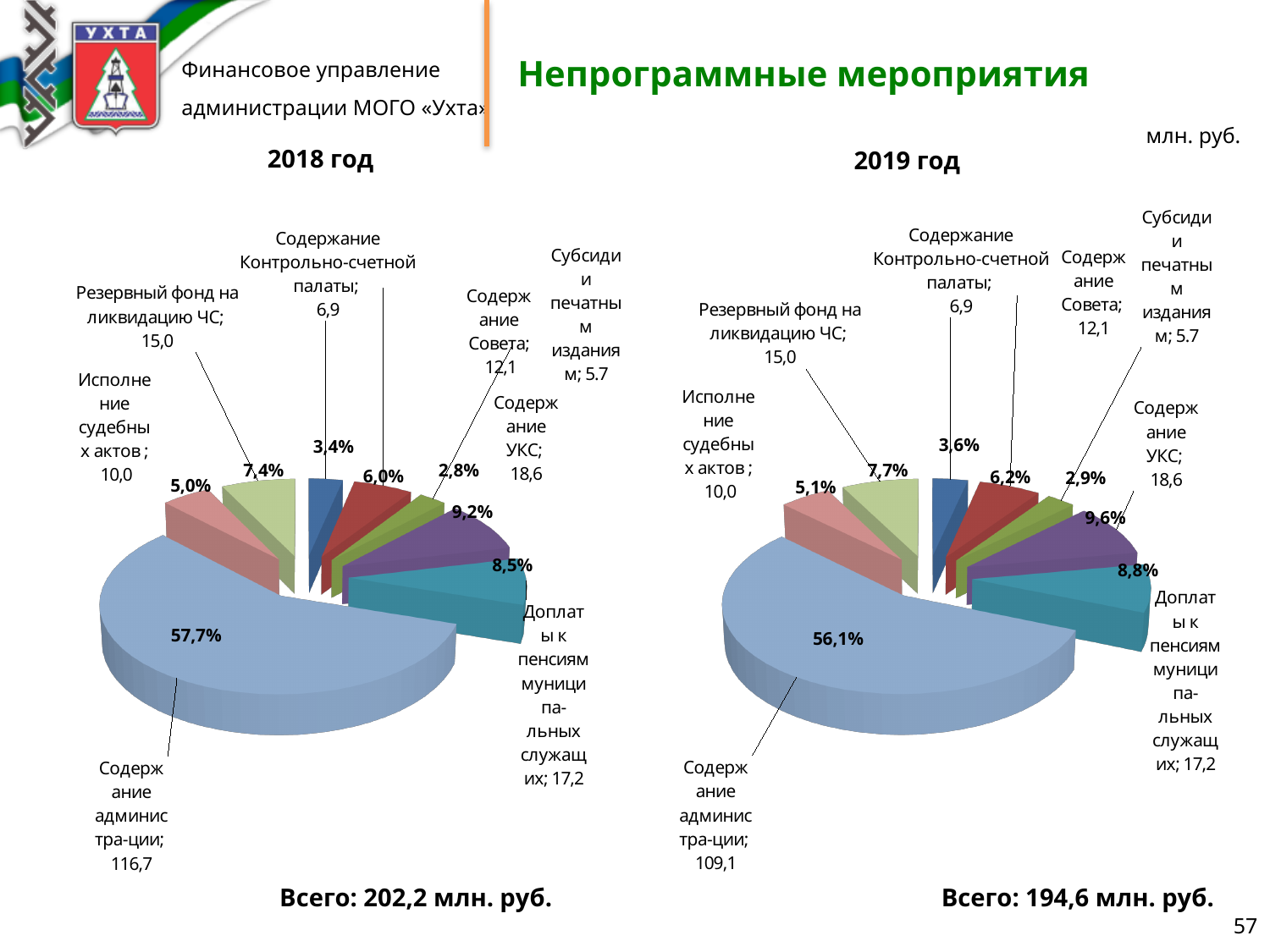
On the 2019 год chart, which category has the largest slice? Содержание администрации On the 2018 год chart, what share of the pie does Содержание администрации take? 57,7% On the 2019 год chart, what is the value for Содержание администрации? 109,1 On the 2018 год chart, which category has the smallest slice? Субсидии печатным изданиям On the 2019 год chart, what share of the pie does Содержание УКС take? 9,6% On the 2018 год chart, what is the difference between the values for Содержание УКС and Содержание Совета? 6,5 How many slices does the 2018 год pie chart have? 8 What type of chart is used for 2019 год? Pie chart On the 2019 год chart, which is larger: Резервный фонд на ликвидацию ЧС or Исполнение судебных актов? Резервный фонд на ликвидацию ЧС On the 2018 год chart, what is the value for Содержание администрации? 116,7 On the 2019 год chart, what is the value for Доплаты к пенсиям муниципальных служащих? 17,2 What total is shown under the 2019 год chart? 194,6 млн. руб.